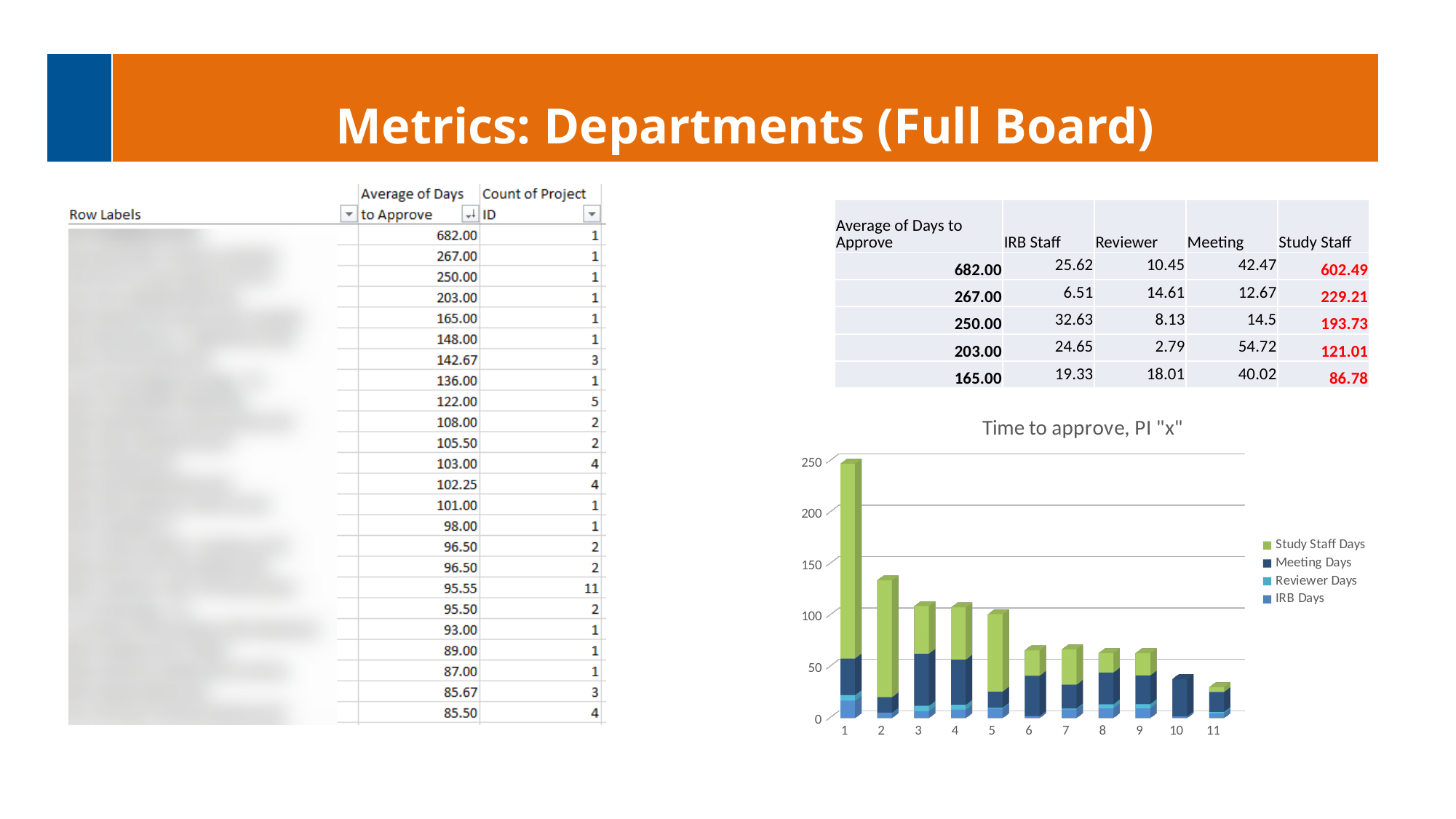
In the "Time to approve, PI "x"" chart, which category has the shortest stacked bar? 11 In the "Time to approve, PI "x"" chart, is the total for category 1 greater or less than 200? greater How many categories are shown on the x axis of the "Time to approve, PI "x"" chart? 11 How many series does the legend of the "Time to approve, PI "x"" chart list? 4 What is the title of the chart on the slide? Time to approve, PI "x" In the "Time to approve, PI "x"" chart, which series is shown in green? Study Staff Days In the "Time to approve, PI "x"" chart, is the total for category 10 greater or less than 50? less In the "Time to approve, PI "x"" chart, is the total for category 2 greater or less than 100? greater In the "Time to approve, PI "x"" chart, do the stacked bar totals rise or fall from category 1 to category 11? Fall In the "Time to approve, PI "x"" chart, which category has the tallest stacked bar? 1 What kind of chart is "Time to approve, PI "x""? Stacked bar chart